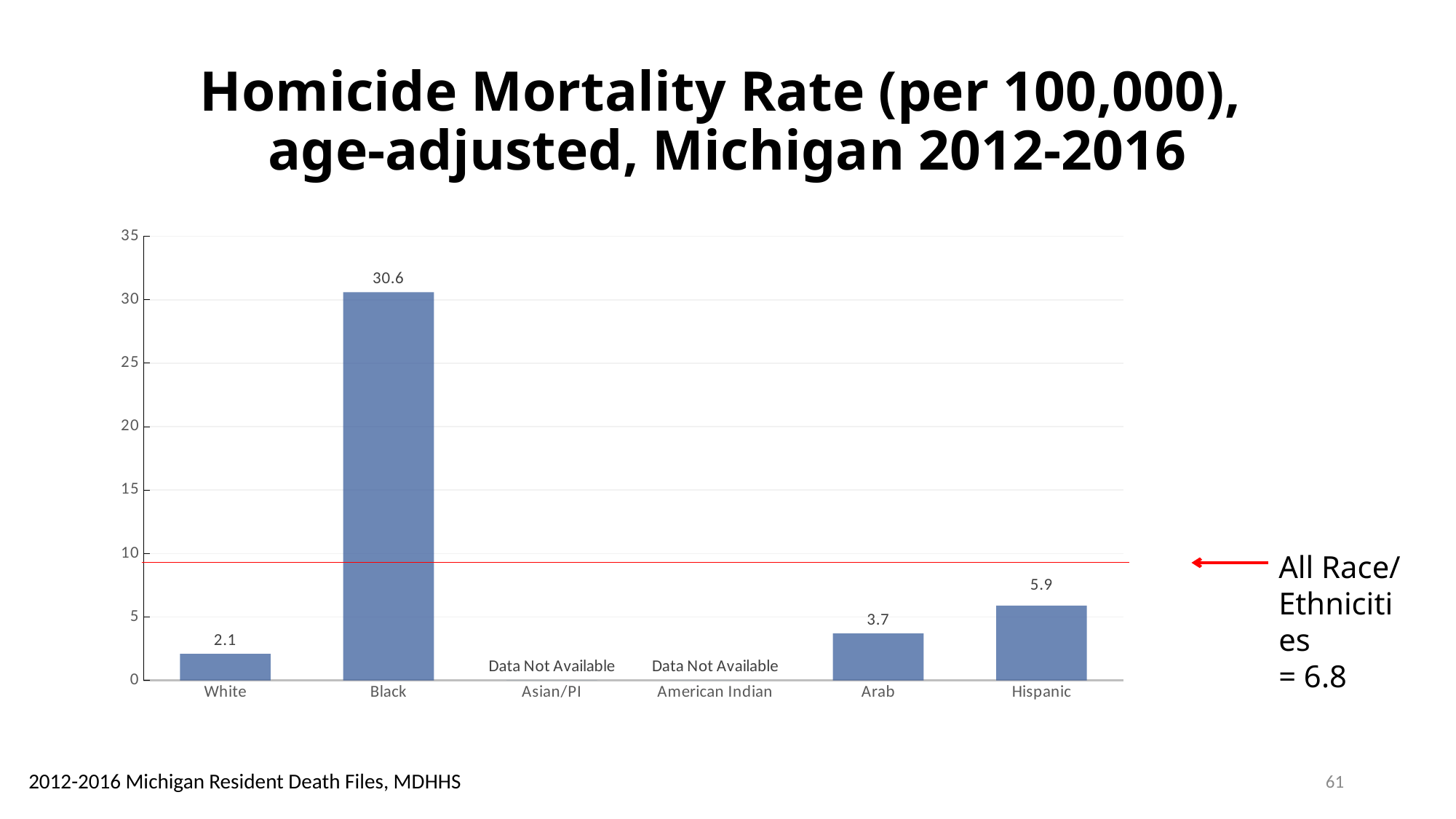
What is the difference between the homicide mortality rates for Black and Hispanic residents? 24.7 What is the homicide mortality rate for Black residents? 30.6 Which category has the highest homicide mortality rate? Black What kind of chart is shown on the slide? Bar chart What is the All Race/Ethnicities rate indicated by the red line? 6.8 What is the homicide mortality rate for White residents? 2.1 How many categories are shown on the x axis? 6 Among the categories with a plotted value, which has the lowest homicide mortality rate? White What is the homicide mortality rate for Hispanic residents? 5.9 Which is larger, the rate for Arab residents or the rate for Hispanic residents? Hispanic What is the homicide mortality rate for Arab residents? 3.7 Is the value for Black greater or less than 30? greater